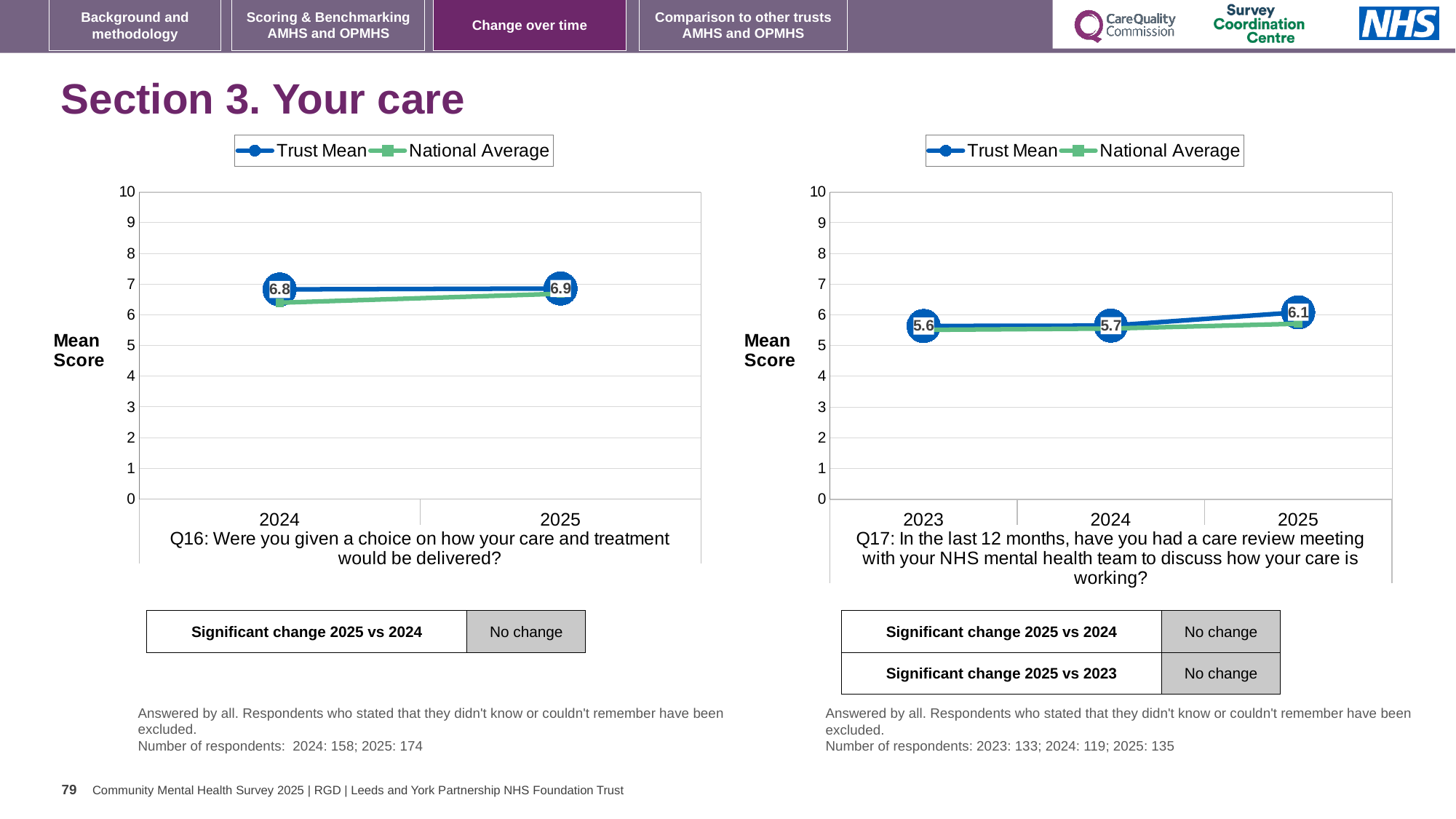
How many series does the legend of the Q16 chart (left) list? 2 What type of chart is the Q16 chart (left)? line chart On the Q17 chart (right), does the Trust Mean rise or fall from 2023 to 2025? rise On the Q17 chart (right), what is the Trust Mean for 2023? 5.6 On the Q17 chart (right), in which year is the Trust Mean highest? 2025 How many years are plotted on the Q17 chart (right)? 3 On the Q16 chart (left), what is the Trust Mean for 2025? 6.9 On the Q17 chart (right), what is the Trust Mean for 2025? 6.1 On the Q16 chart (left), is the National Average for 2024 greater or less than 7? less On the Q17 chart (right), in which year is the Trust Mean lowest? 2023 On the Q17 chart (right), by how much did the Trust Mean change from 2023 to 2025? 0.5 On the Q16 chart (left), what is the Trust Mean for 2024? 6.8